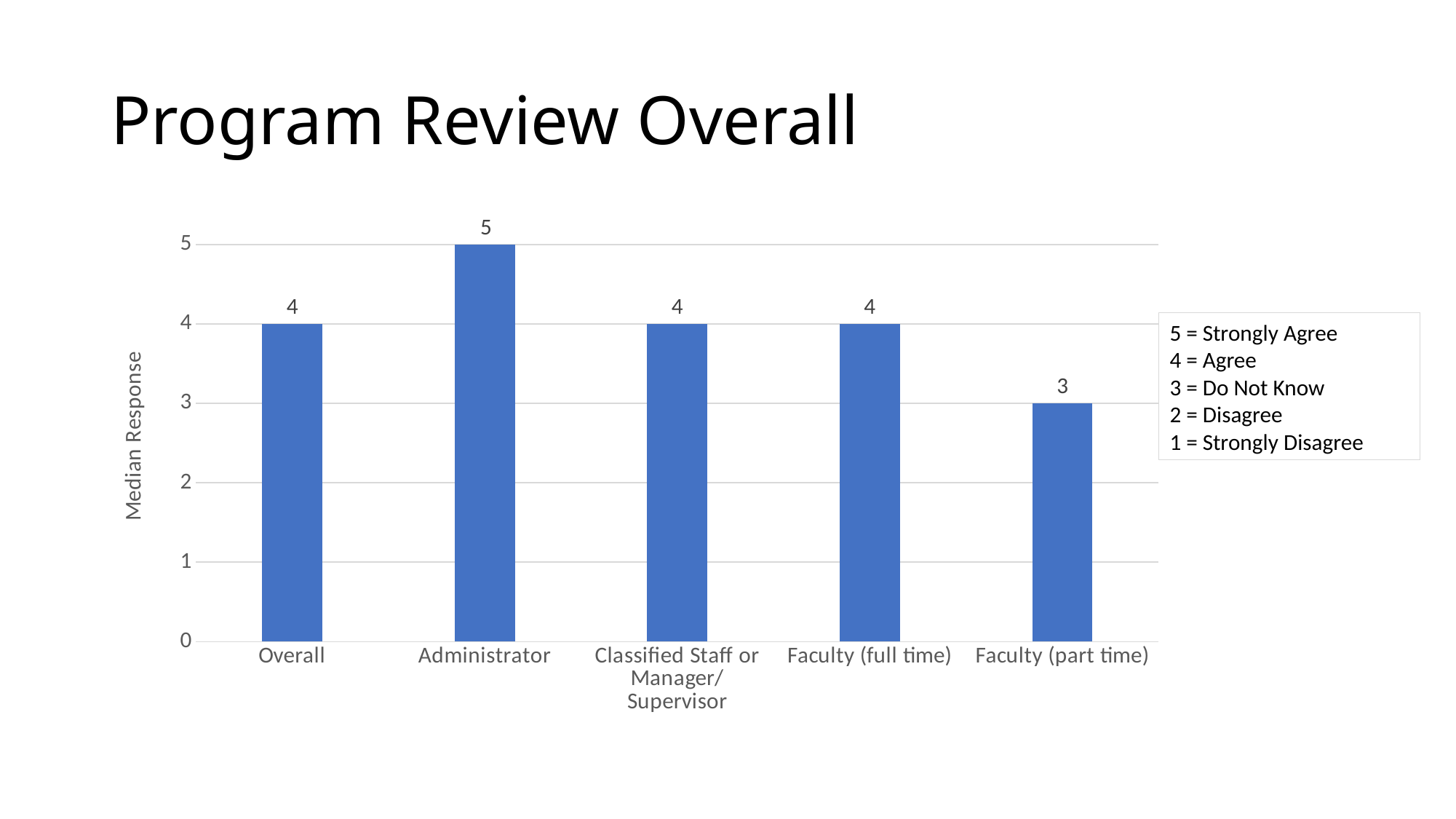
According to the key on the slide, what does a response of 5 mean? Strongly Agree What kind of chart is shown on the slide? Bar chart Which category has the highest median response? Administrator What is the median response for Faculty (part time)? 3 What is the median response for Classified Staff or Manager/Supervisor? 4 What is the median response for Administrator? 5 What is the median response for Overall? 4 How many categories are shown on the x axis? 5 What is the label of the y axis? Median Response Which category has the lowest median response? Faculty (part time) What is the difference between the median response for Administrator and Faculty (part time)? 2 Which has a larger median response, Faculty (full time) or Faculty (part time)? Faculty (full time)